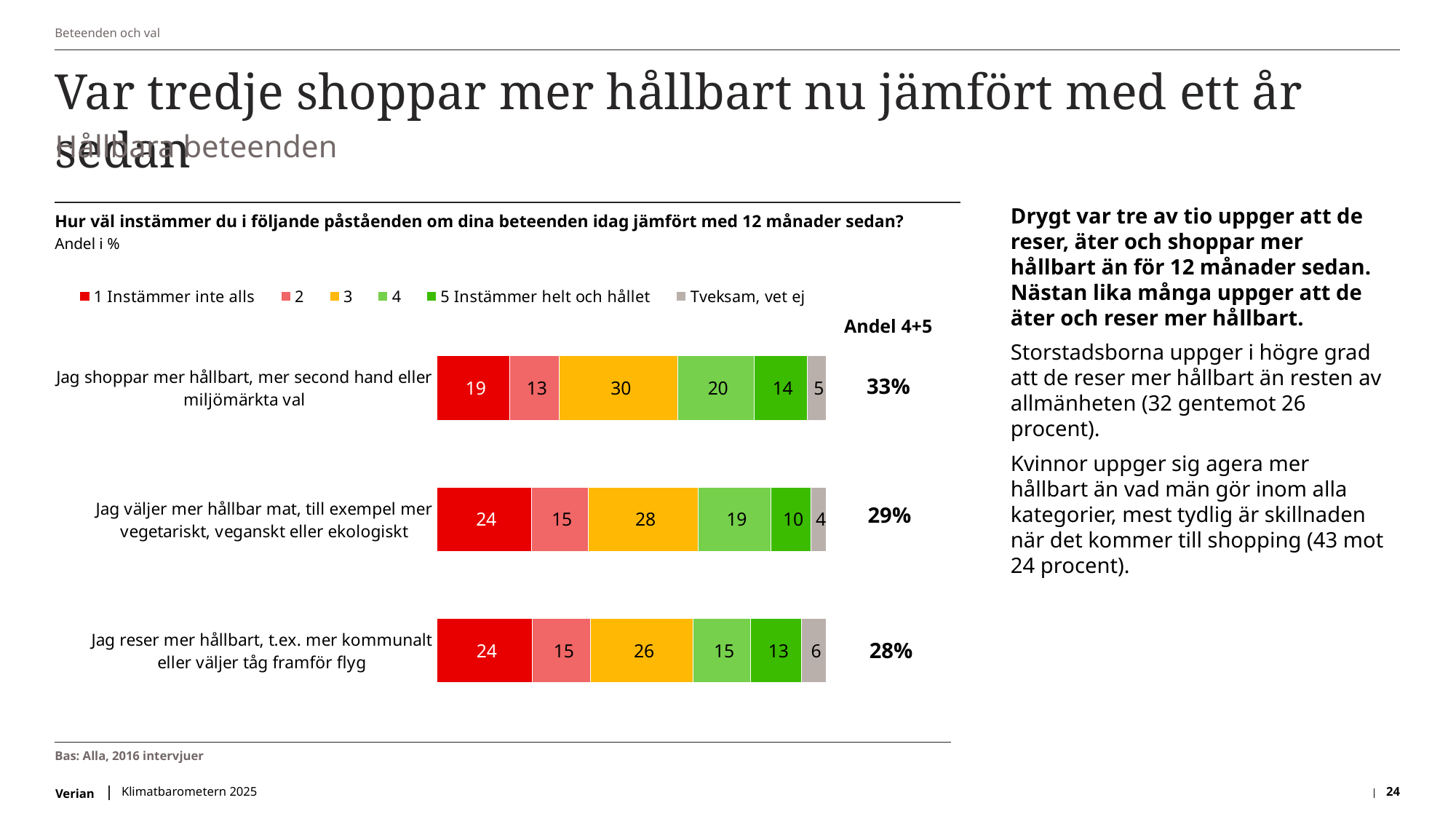
Which legend entry is shown in grey? Tveksam, vet ej Which statement has the highest 'Andel 4+5' value? Jag shoppar mer hållbart, mer second hand eller miljömärkta val What is the total of all segments in the bar for 'Jag väljer mer hållbar mat, till exempel mer vegetariskt, veganskt eller ekologiskt'? 100 What kind of chart is shown on the slide? Stacked bar chart What is the 'Andel 4+5' value for 'Jag väljer mer hållbar mat, till exempel mer vegetariskt, veganskt eller ekologiskt'? 29% Which has the larger value for '4': 'Jag shoppar mer hållbart' or 'Jag reser mer hållbart'? Jag shoppar mer hållbart What is the value for '3' in the bar for 'Jag shoppar mer hållbart, mer second hand eller miljömärkta val'? 30 How many series does the chart legend list? 6 Which statement has the lowest value for '5 Instämmer helt och hållet'? Jag väljer mer hållbar mat, till exempel mer vegetariskt, veganskt eller ekologiskt What is the value for '1 Instämmer inte alls' in the bar for 'Jag reser mer hållbart, t.ex. mer kommunalt eller väljer tåg framför flyg'? 24 What is the difference between the '3' value for 'Jag shoppar mer hållbart' and the '3' value for 'Jag reser mer hållbart'? 4 How many statements (categories) are plotted in the chart? 3